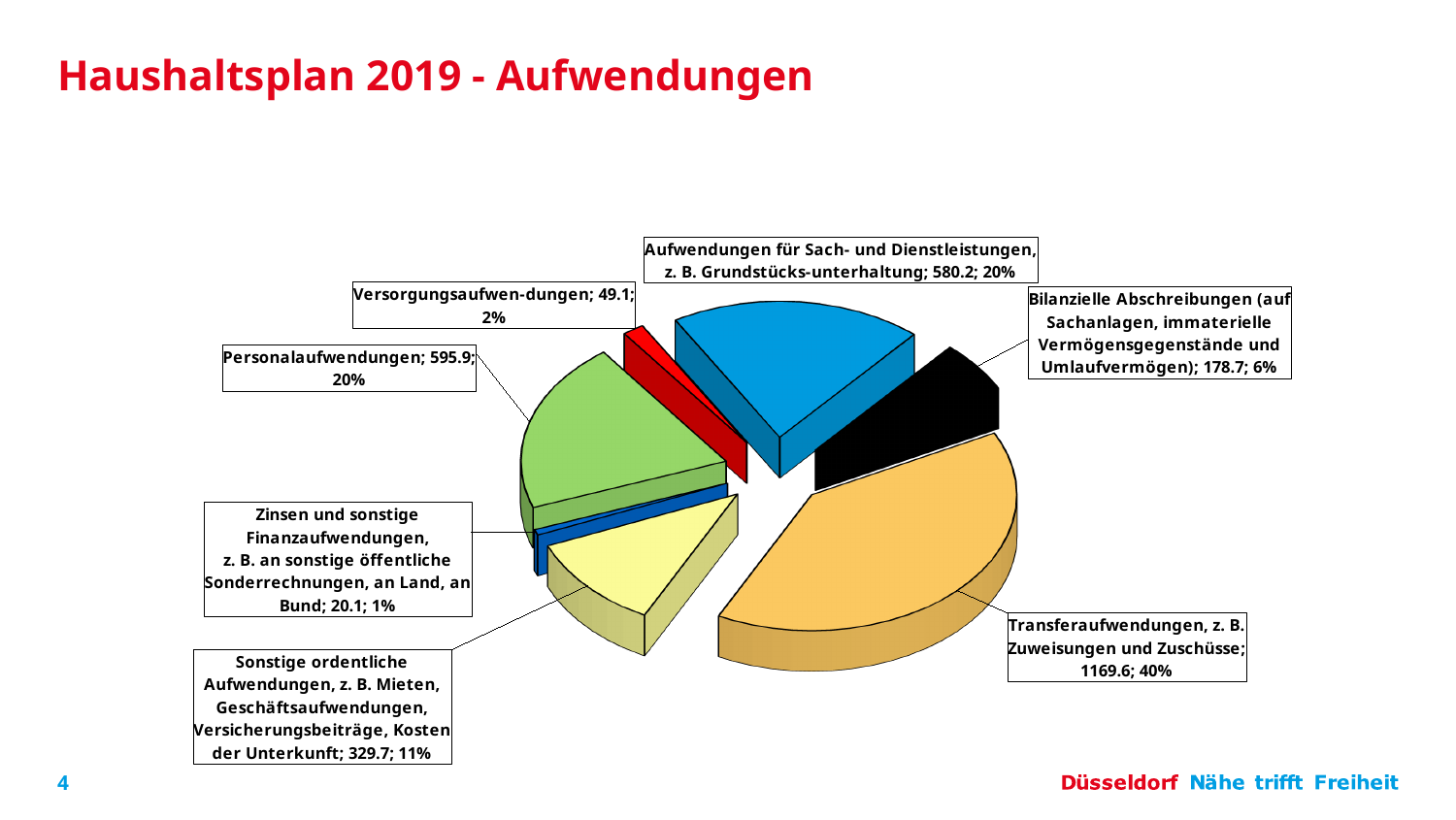
Which is larger, the value for Sonstige ordentliche Aufwendungen or the value for Bilanzielle Abschreibungen? Sonstige ordentliche Aufwendungen How many slices does the pie chart have? 7 Which category has the largest slice of the pie? Transferaufwendungen, z. B. Zuweisungen und Zuschüsse Which category has the smallest slice of the pie? Zinsen und sonstige Finanzaufwendungen What is the title of the slide containing the chart? Haushaltsplan 2019 - Aufwendungen What percentage is shown for Bilanzielle Abschreibungen? 6% What is the value shown for Personalaufwendungen? 595.9 What is the difference between the values for Personalaufwendungen and Aufwendungen für Sach- und Dienstleistungen? 15.7 What kind of chart is shown on the slide? Pie chart What share of the pie does Transferaufwendungen, z. B. Zuweisungen und Zuschüsse represent? 40% What is the value shown for Versorgungsaufwendungen? 49.1 What is the value shown for Transferaufwendungen, z. B. Zuweisungen und Zuschüsse? 1169.6